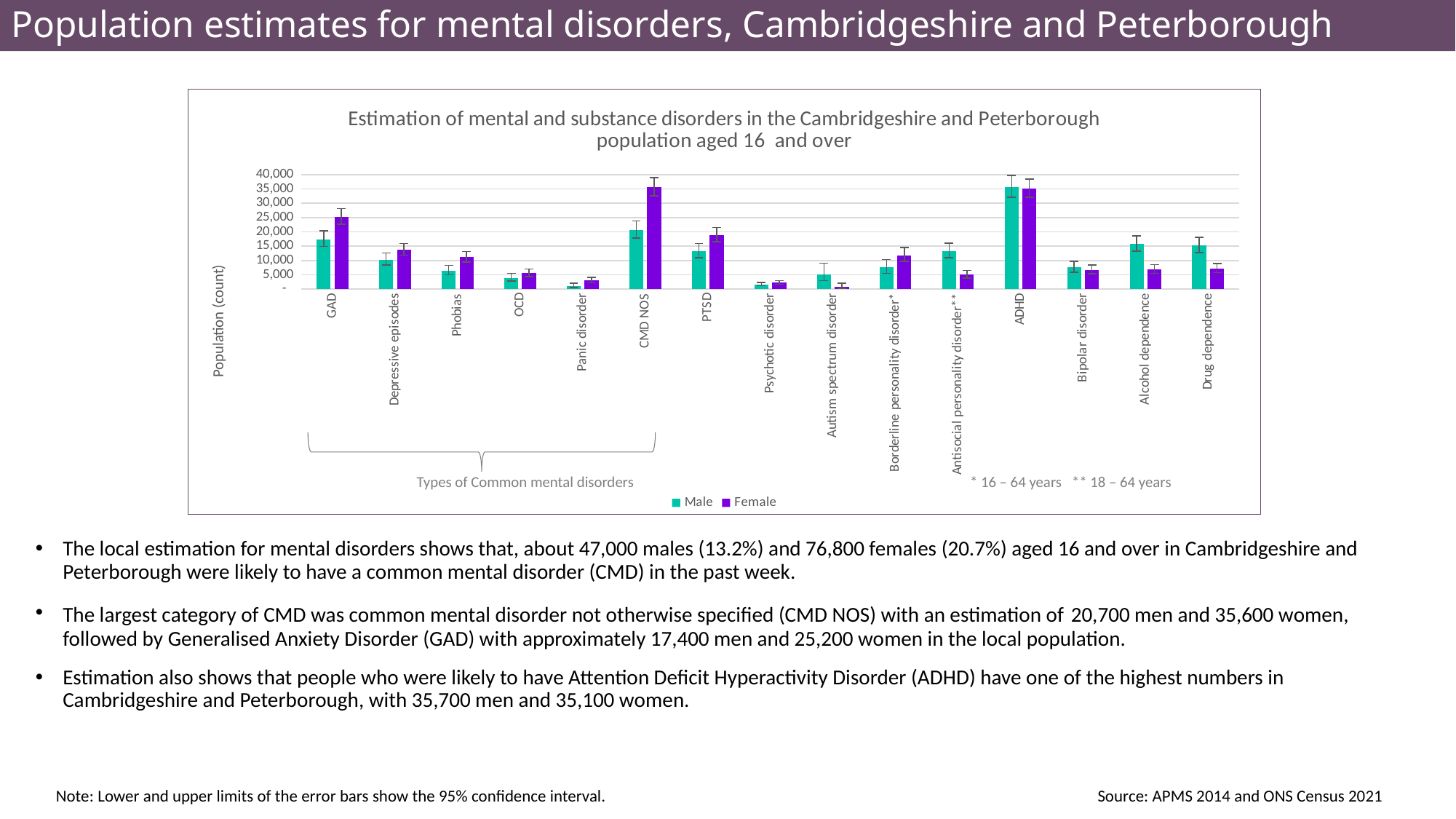
How many series does the chart legend list? 2 What is the difference between the Female and Male estimates for CMD NOS? 14,900 According to the slide, what is the estimated number of women with CMD NOS? 35,600 What type of chart is shown on the slide? Bar chart Which category has the highest Male value in the chart? ADHD How many disorder categories are shown on the x axis of the chart? 15 According to the slide, what is the estimated number of men with ADHD? 35,700 What is the difference between the Female and Male estimates for GAD? 7,800 For Antisocial personality disorder, which is larger, the Male or the Female value? Male Which colour represents the Female series in the chart? Purple Is the Male value for PTSD greater or less than 15,000? less Is the Female value for GAD greater or less than 20,000? greater